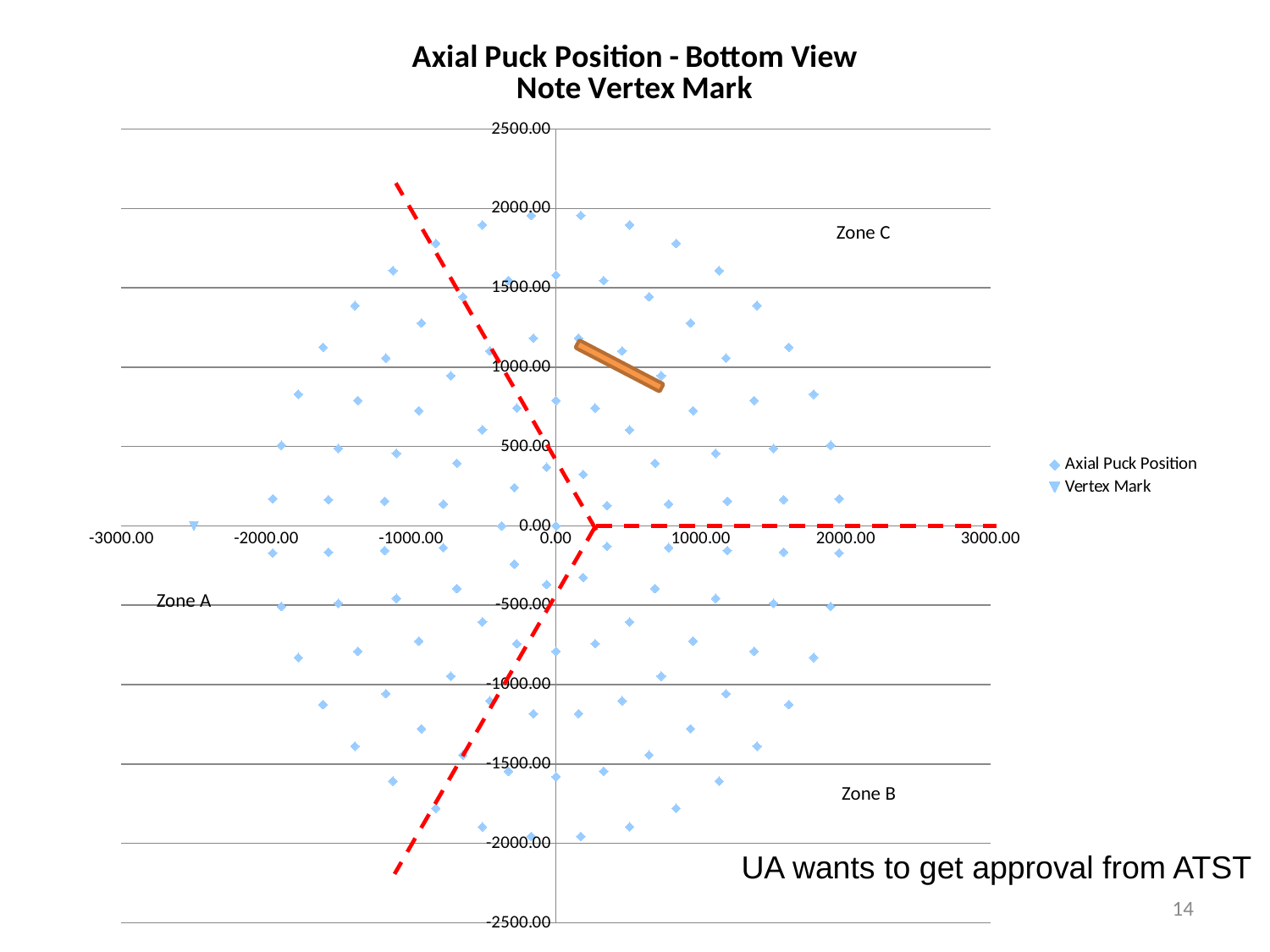
What is the title of the chart? Axial Puck Position - Bottom View Note Vertex Mark How many series does the legend list? 2 Which zone label appears in the upper right region of the chart? Zone C What is the maximum value shown on the vertical axis? 2500.00 What kind of chart is shown on the slide? Scatter chart Is the x value of the Vertex Mark point greater or less than -3000.00? greater Is the x value of the Vertex Mark point greater or less than -2000.00? less